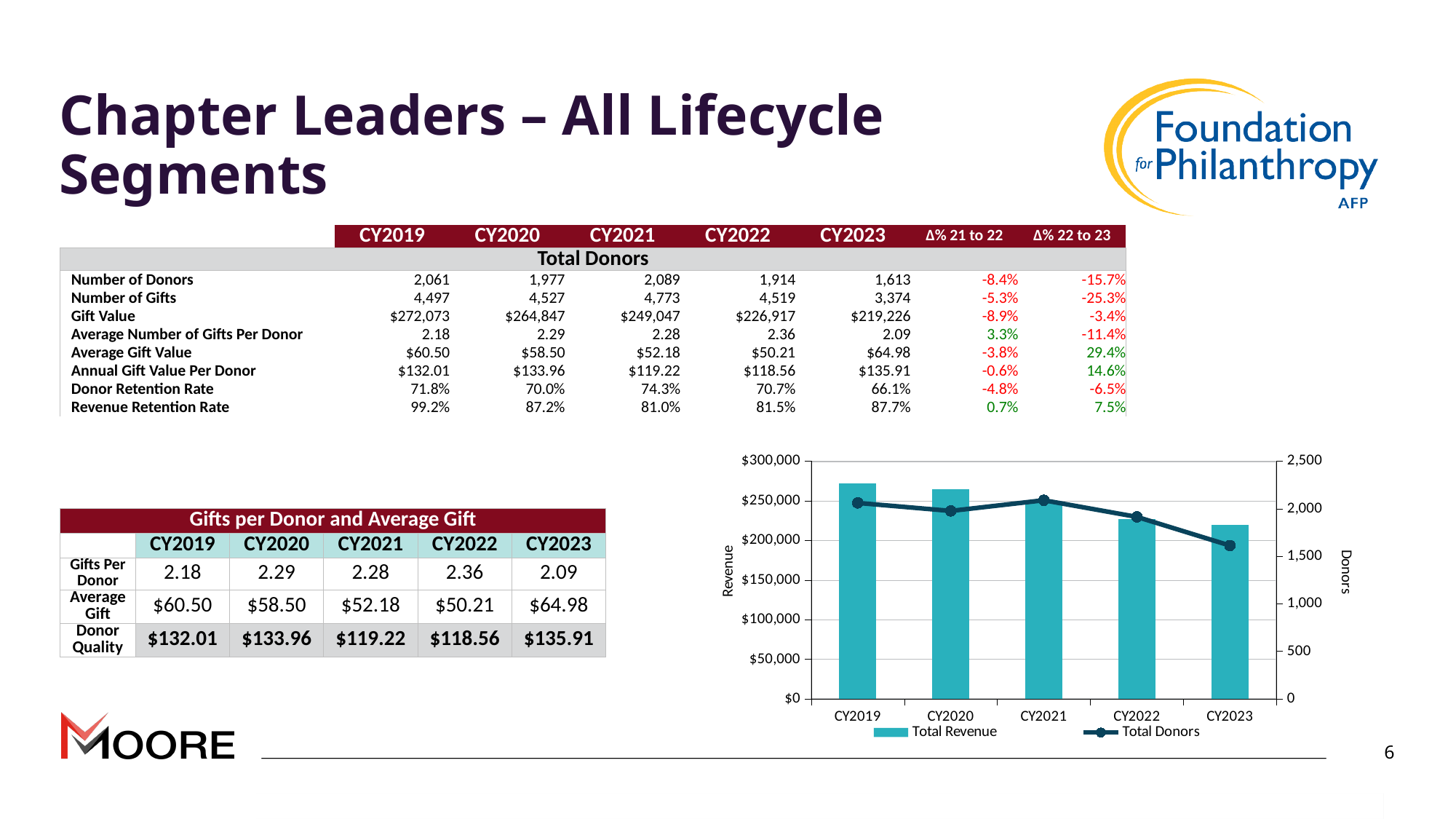
Which year has the highest Total Revenue bar in the chart? CY2019 Which year has the lowest Total Donors point in the chart? CY2023 What kind of chart is shown on the slide? A combined bar and line chart How many years are plotted along the x axis of the chart? 5 Is the Total Revenue for CY2019 greater or less than $250,000? greater Which is larger in the chart, the Total Revenue for CY2021 or for CY2023? CY2021 Is the Total Revenue for CY2023 greater or less than $250,000? less Do the Total Revenue bars generally rise or fall from CY2019 to CY2023? fall Which year has the lowest Total Revenue bar in the chart? CY2023 Is the Total Donors value for CY2023 greater or less than 2,000? less What is the label on the right-hand vertical axis of the chart? Donors How many series does the chart's legend list? 2